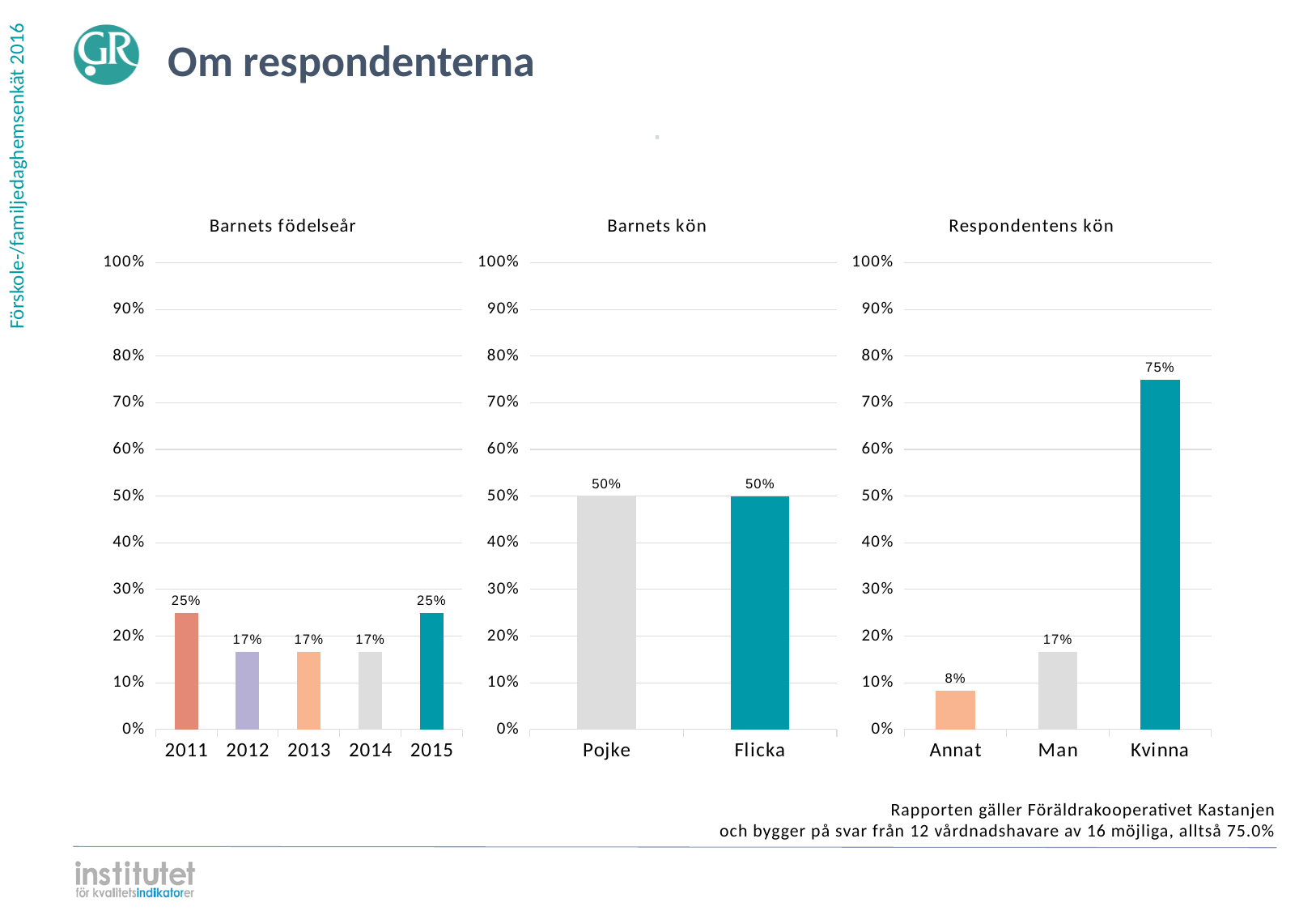
In the 'Barnets födelseår' chart, what is the difference between the values for 2015 and 2014? 8% In the 'Barnets födelseår' chart, what is the value for 2013? 17% In the 'Barnets födelseår' chart, how many birth-year categories are shown? 5 In the 'Respondentens kön' chart, what is the difference between the values for Kvinna and Man? 58% In the 'Respondentens kön' chart, which category has the highest value? Kvinna In the 'Barnets kön' chart, what is the value for Pojke? 50% In the 'Respondentens kön' chart, is the value for Kvinna greater or less than 70%? greater In the 'Barnets kön' chart, what is the difference between the values for Pojke and Flicka? 0% In the 'Respondentens kön' chart, which category has the lowest value? Annat In the 'Barnets födelseår' chart, what is the value for 2011? 25% In the 'Respondentens kön' chart, what is the value for Man? 17% What kind of chart is the 'Barnets kön' chart? Bar chart